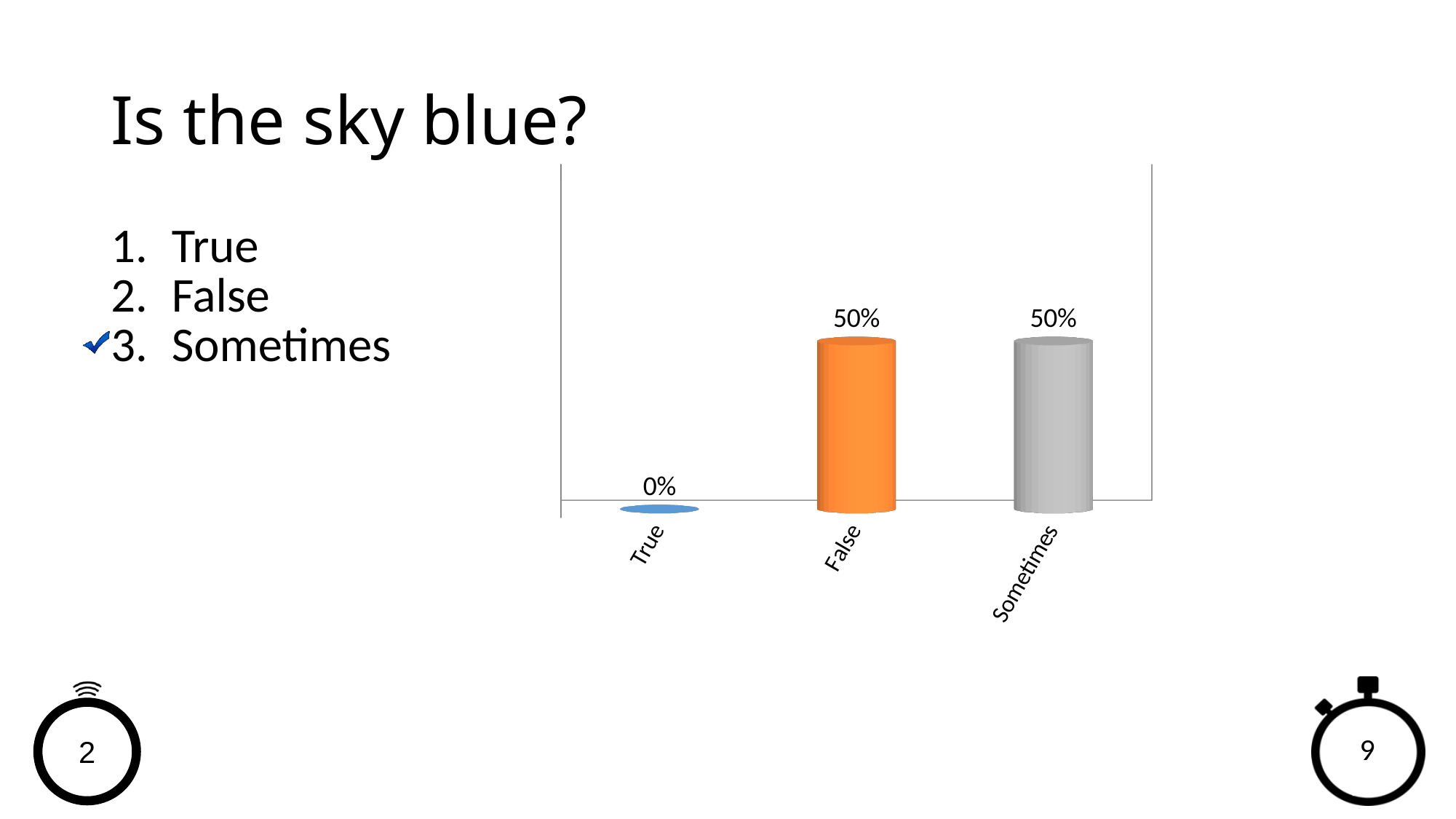
What is the value for False? 50% Which category has the lowest value? True What kind of chart is shown on the slide? Bar chart What is the value for True? 0% What colour is the bar for False? Orange Which answer option is marked with a check mark on the slide? Sometimes How many categories are shown on the chart? 3 Which is larger, the value for True or the value for Sometimes? Sometimes What is the difference between the values for False and True? 50% What is the total of the values for False and Sometimes? 100% What is the value for Sometimes? 50%